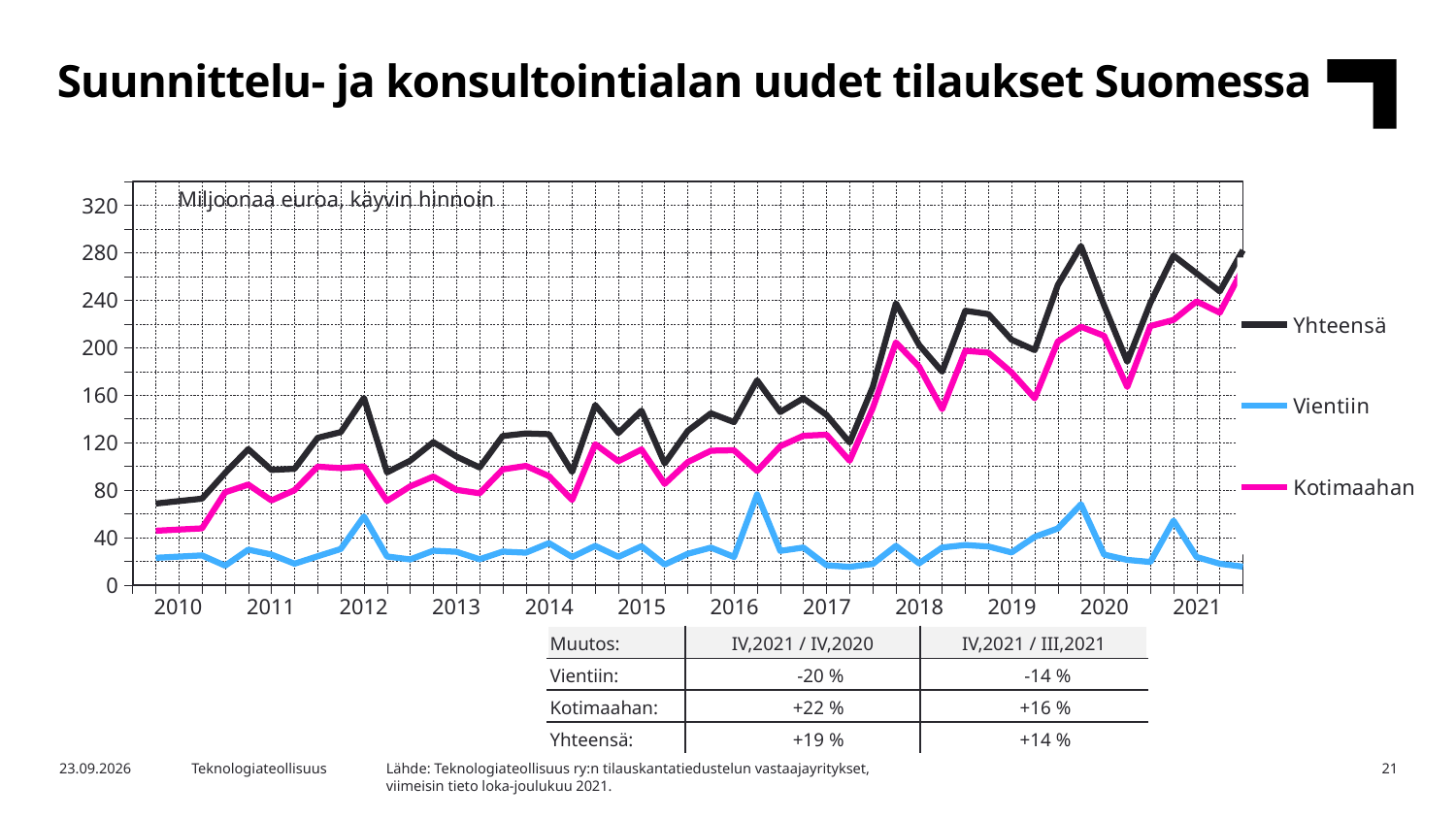
What kind of chart is shown on the slide? line chart Which series has the lowest values throughout the chart? Vientiin Which series are listed in the legend? Yhteensä, Vientiin, Kotimaahan How many years are labelled on the x axis? 12 Is the value for Kotimaahan at the end of 2021 greater or less than 240? greater Which series has the highest values throughout the chart? Yhteensä What unit is stated at the top of the chart area? Miljoonaa euroa, käyvin hinnoin How many series does the legend list? 3 Is the value for Yhteensä at the start of 2010 greater or less than 80? less Is the peak value for Vientiin in 2012 greater or less than 40? greater Does the Yhteensä series overall rise or fall from 2010 to 2021? rise In 2018, which is larger, Kotimaahan or Vientiin? Kotimaahan